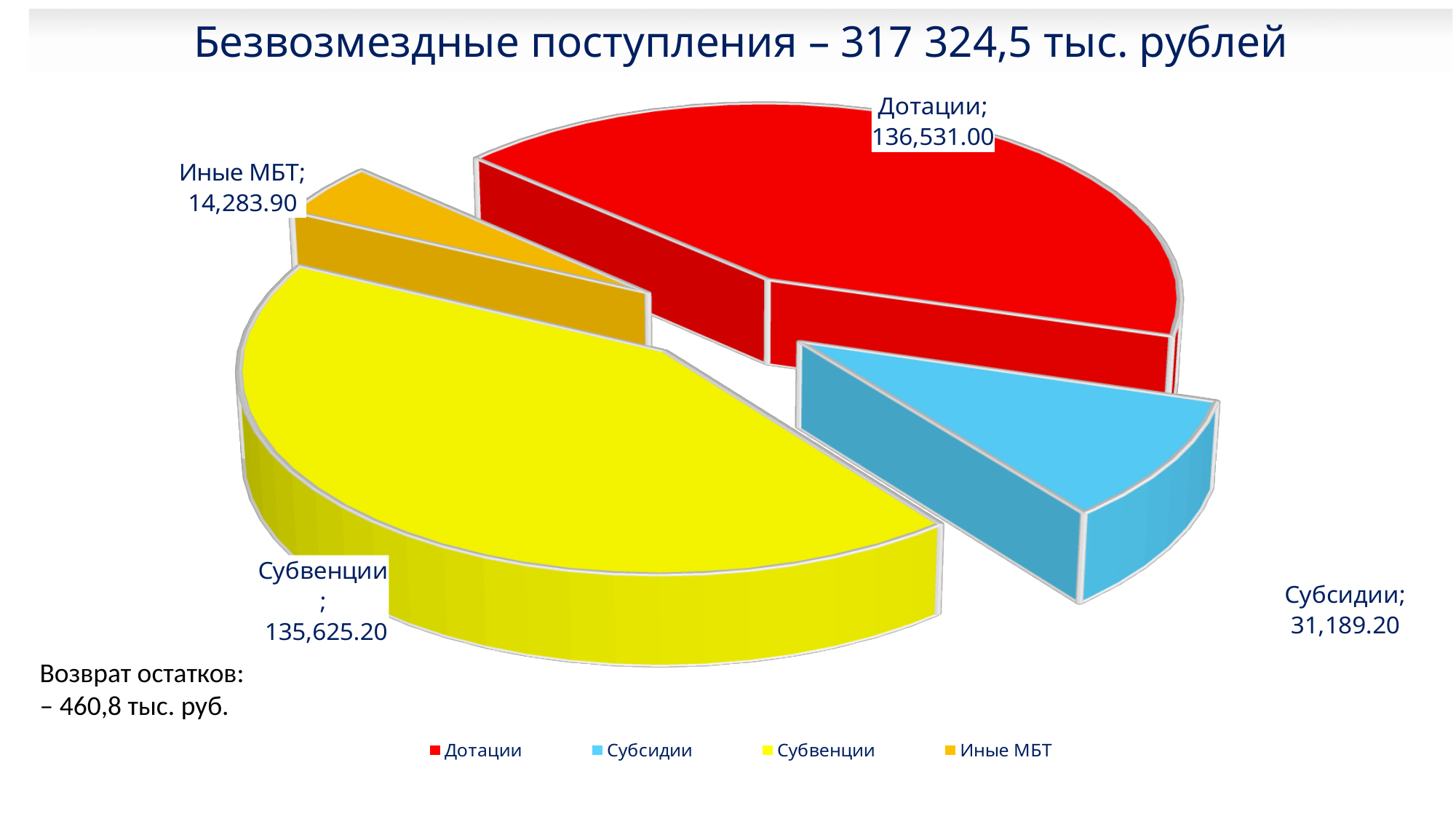
What is the difference between the values for Дотации and Субсидии? 105,341.80 Which category has the smallest slice of the pie? Иные МБТ Which is larger, the value for Субсидии or the value for Иные МБТ? Субсидии What is the title of the chart? Безвозмездные поступления – 317 324,5 тыс. рублей What is the value shown for Субвенции? 135,625.20 How many slices does the pie chart have? 4 What kind of chart is shown on the slide? Pie chart What is the value shown for Субсидии? 31,189.20 What is the value shown for Иные МБТ? 14,283.90 Which category has the largest slice of the pie? Дотации What is the difference between the values for Субвенции and Иные МБТ? 121,341.30 What is the value shown for Дотации? 136,531.00